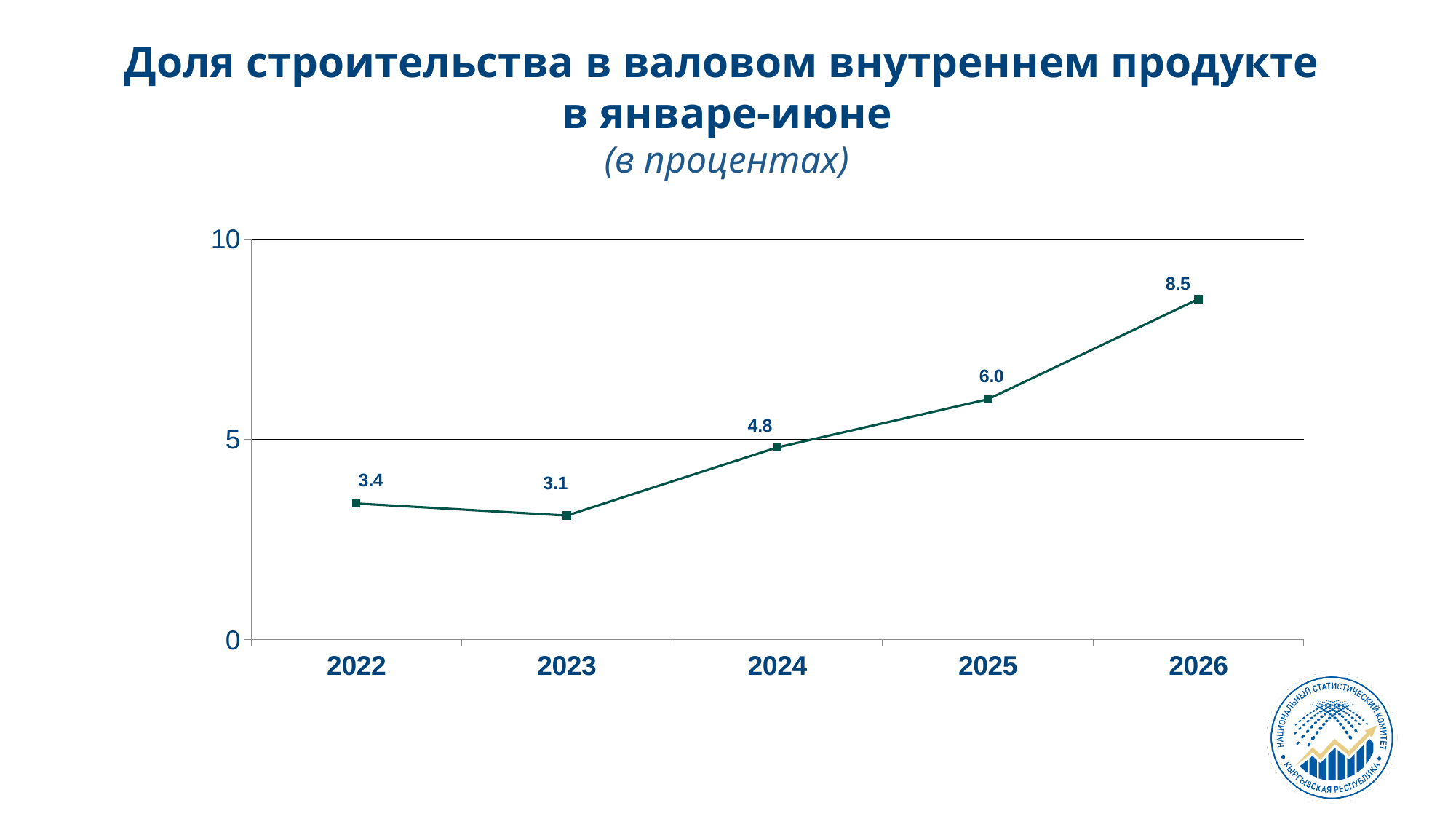
What is the value for 2026? 8.5 Which is larger, the value for 2022 or the value for 2023? 2022 How many years are plotted on the chart? 5 What kind of chart is shown on the slide? line chart Do the values rise or fall from 2023 to 2026? rise What is the value for 2022? 3.4 Which year has the lowest value? 2023 What is the difference between the values for 2026 and 2025? 2.5 What is the value for 2024? 4.8 Which year has the highest value? 2026 Is the value for 2025 greater or less than 5? greater What is the difference between the values for 2024 and 2023? 1.7